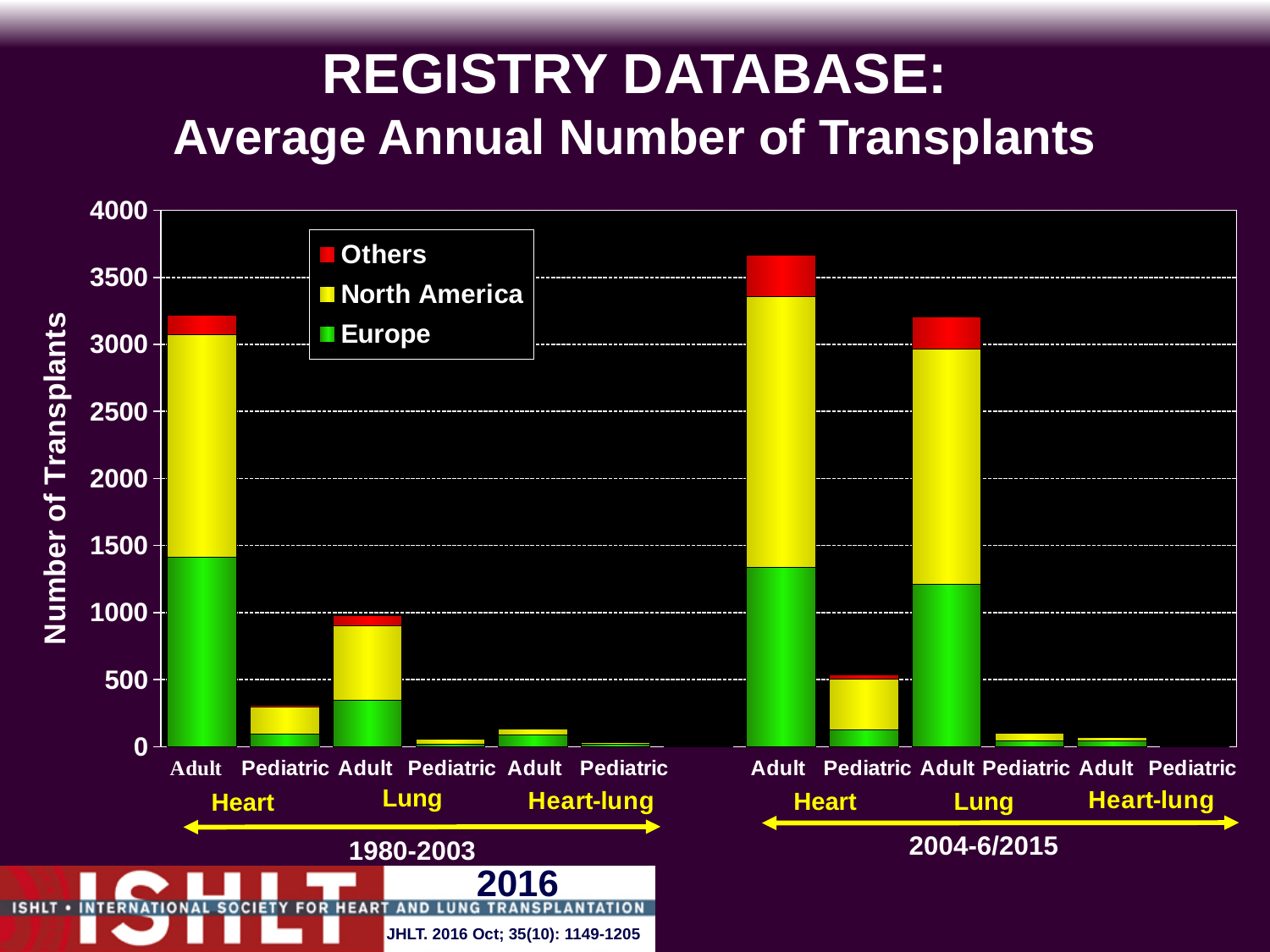
Is the total for Adult Heart in 1980-2003 greater or less than 3000? greater Which series are listed in the legend? Others, North America, Europe What kind of chart is shown on the slide? Stacked bar chart Is the total for Pediatric Heart in 1980-2003 greater or less than 500? less How many series does the legend list? 3 How many bars are plotted in the chart? 12 Which is larger, the total for Adult Lung in 1980-2003 or the total for Adult Lung in 2004-6/2015? Adult Lung in 2004-6/2015 Which bar has the highest total number of transplants? Adult Heart, 2004-6/2015 Is the total for Adult Heart in 2004-6/2015 greater or less than 3500? greater What colour represents Europe in the chart? Green